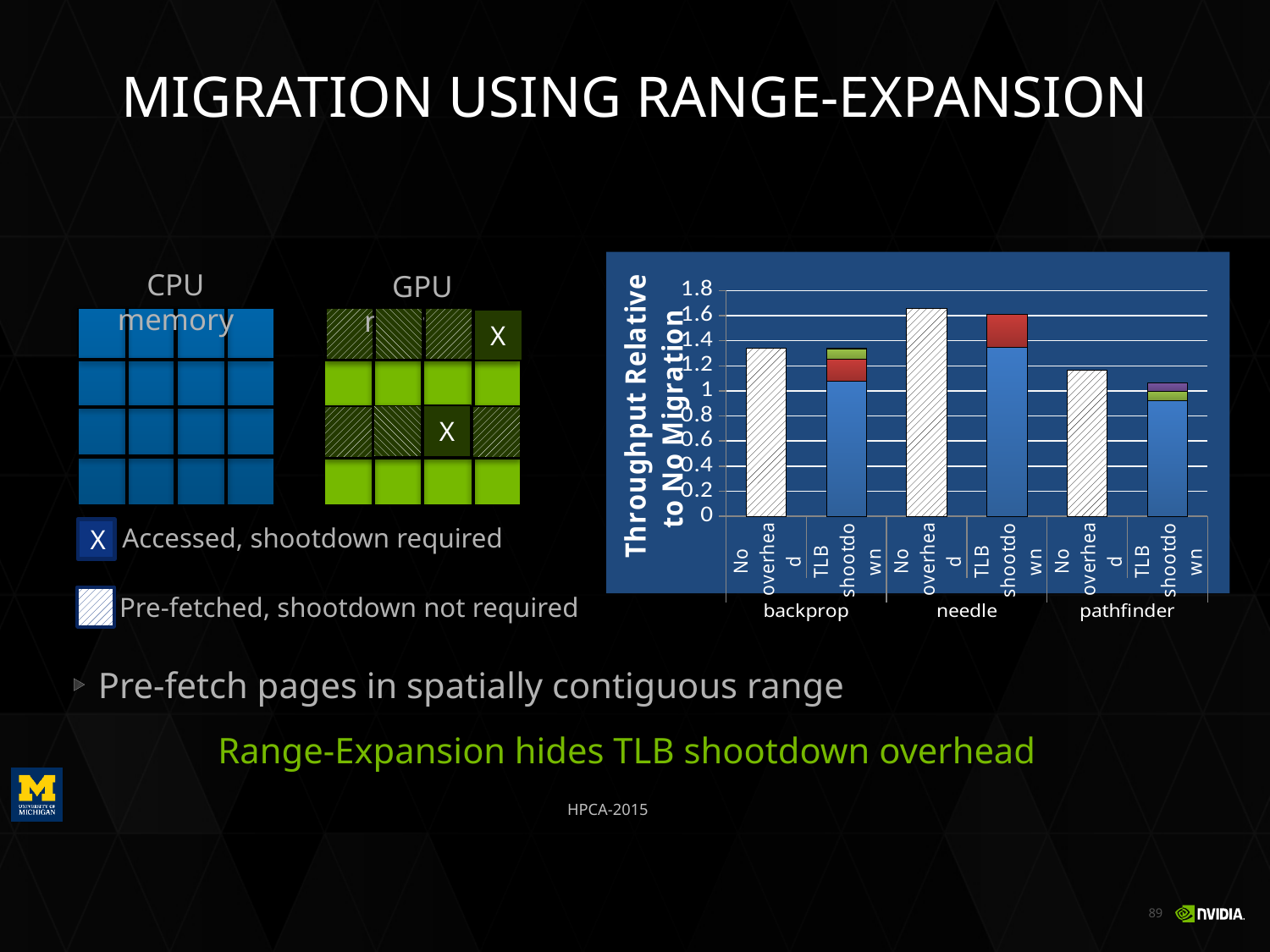
How many bars are plotted in the chart in total? 6 How many benchmark groups are shown along the x axis of the chart? 3 Which benchmark has the lowest 'No overhead' bar in the chart? pathfinder Is the total height of the 'TLB shootdown' bar for pathfinder greater or less than 1.2? less Which benchmark has the highest 'No overhead' bar in the chart? needle Is the 'No overhead' value for backprop greater or less than 1.2? greater Is the 'No overhead' value for pathfinder greater or less than 1.4? less What kind of chart is shown on the slide? bar chart What are the three benchmark names shown on the x axis of the chart? backprop, needle, pathfinder What is the title of the y axis of the chart? Throughput Relative to No Migration Which is larger, the 'No overhead' bar for needle or the 'No overhead' bar for backprop? needle